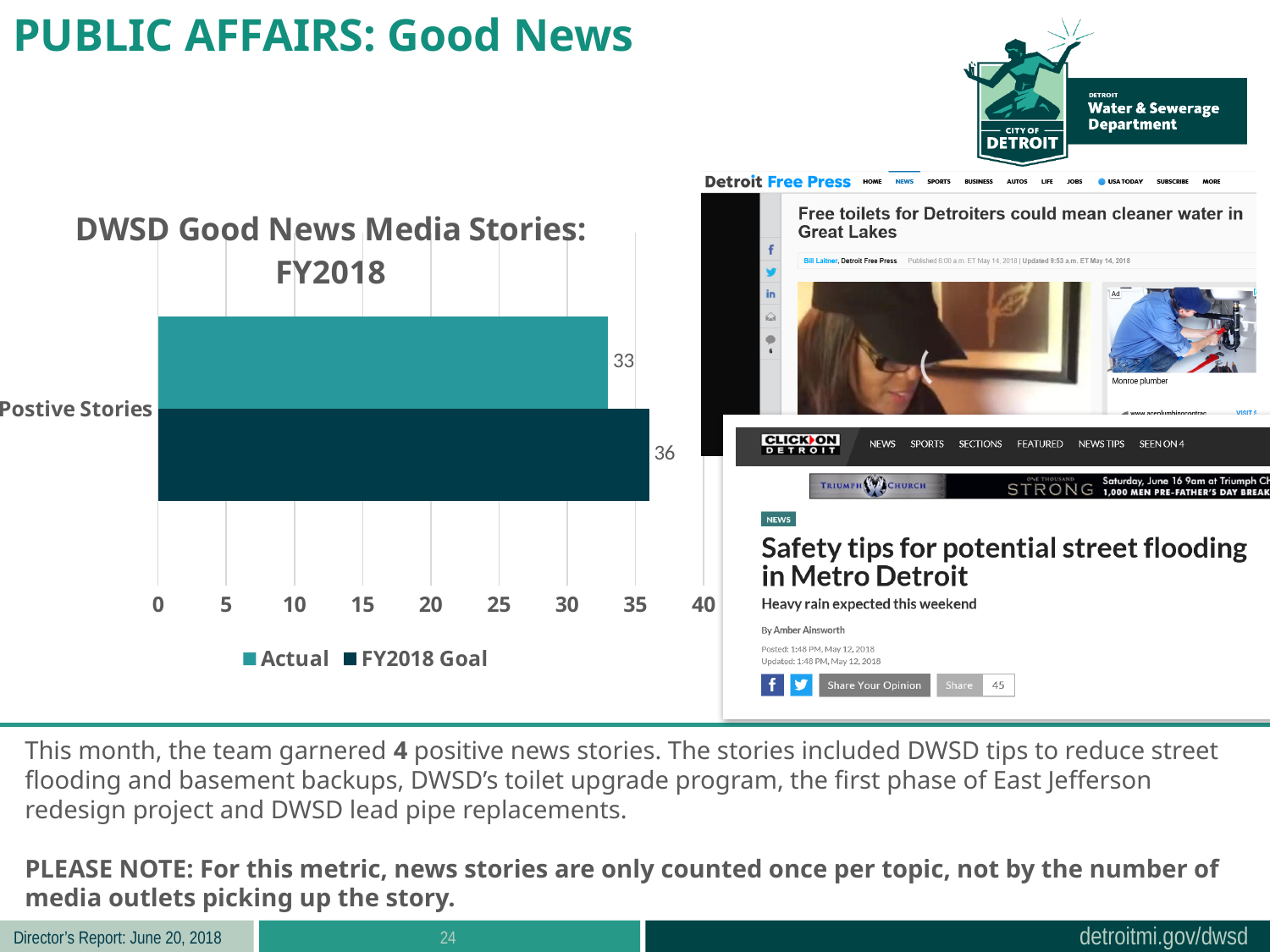
How many series does the legend of the DWSD Good News Media Stories chart list? 2 What is the FY2018 Goal value for Postive Stories? 36 What kind of chart is the DWSD Good News Media Stories: FY2018 chart? Bar chart Which series has the larger value for Postive Stories, Actual or FY2018 Goal? FY2018 Goal How many categories are shown on the DWSD Good News Media Stories chart? 1 What is the difference between the FY2018 Goal and the Actual value for Postive Stories? 3 What are the two series named in the chart legend? Actual and FY2018 Goal Is the Actual value for Postive Stories greater or less than 30? greater What is the Actual value for Postive Stories in the DWSD Good News Media Stories: FY2018 chart? 33 Is the FY2018 Goal value for Postive Stories greater or less than 40? less What is the title of the chart on the slide? DWSD Good News Media Stories: FY2018 What is the highest value shown on the x axis of the chart? 40